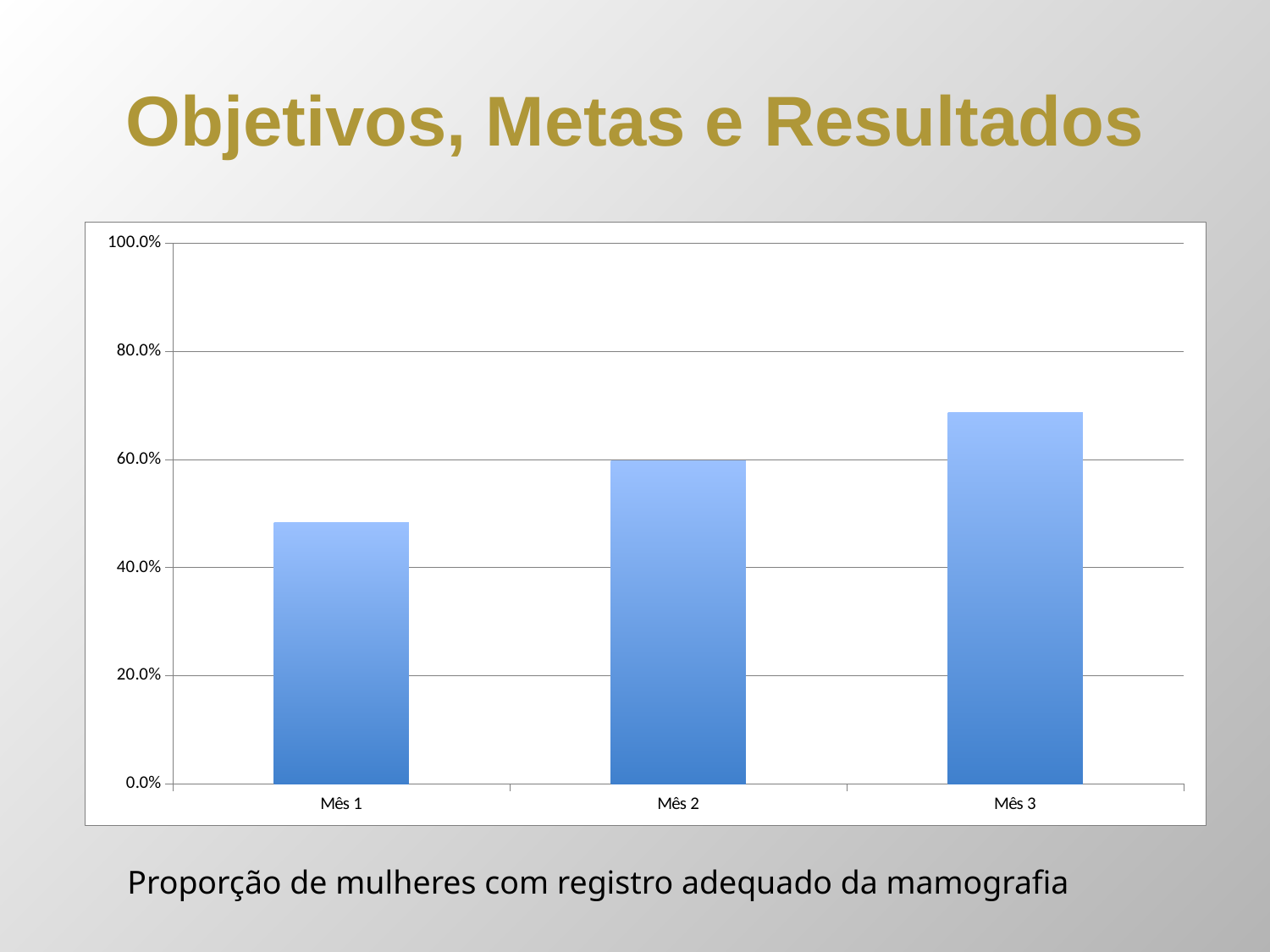
Is the value for Mês 1 greater or less than 40.0%? greater Which is larger, the value for Mês 2 or the value for Mês 3? Mês 3 What kind of chart is shown on the slide? Bar chart Is the value for Mês 3 greater or less than 80.0%? less Do the values rise or fall from Mês 1 to Mês 3? Rise How many categories (months) are plotted on the chart? 3 Is the value for Mês 3 greater or less than 60.0%? greater Which month has the lowest value on the chart? Mês 1 What does the caption below the chart say the chart shows? Proporção de mulheres com registro adequado da mamografia Which month has the highest value on the chart? Mês 3